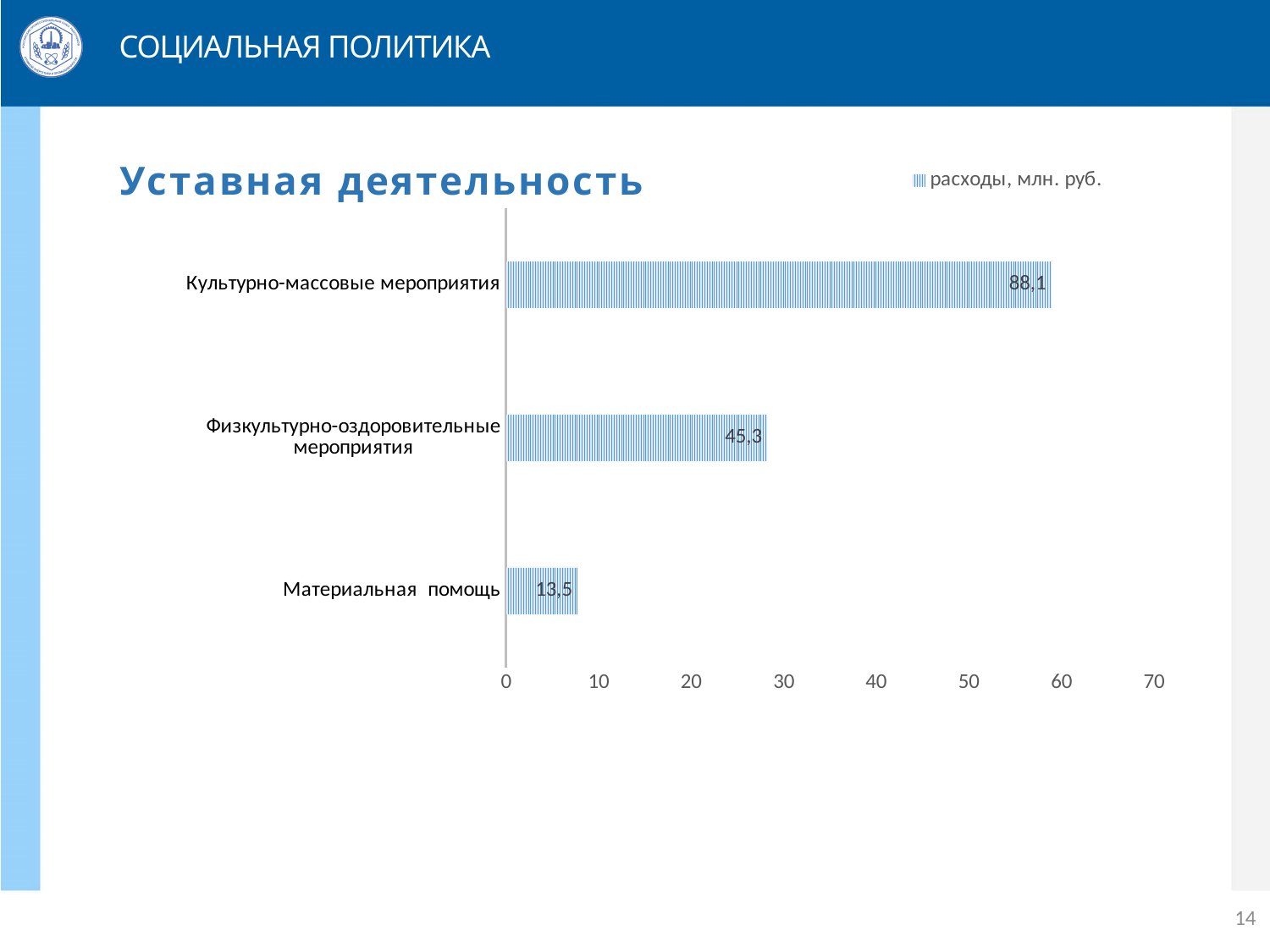
How many categories are shown in the chart? 3 What is the value for Материальная помощь? 13,5 What kind of chart is shown on the slide? bar chart Which is larger, the value for Физкультурно-оздоровительные мероприятия or the value for Материальная помощь? Физкультурно-оздоровительные мероприятия Which category has the lowest value? Материальная помощь What is the value for Физкультурно-оздоровительные мероприятия? 45,3 What is the title of the chart? Уставная деятельность What is the difference between the values for Культурно-массовые мероприятия and Физкультурно-оздоровительные мероприятия? 42,8 Which category has the highest value? Культурно-массовые мероприятия What is the difference between the values for Физкультурно-оздоровительные мероприятия and Материальная помощь? 31,8 What is the value for Культурно-массовые мероприятия? 88,1 How many series does the legend list? 1